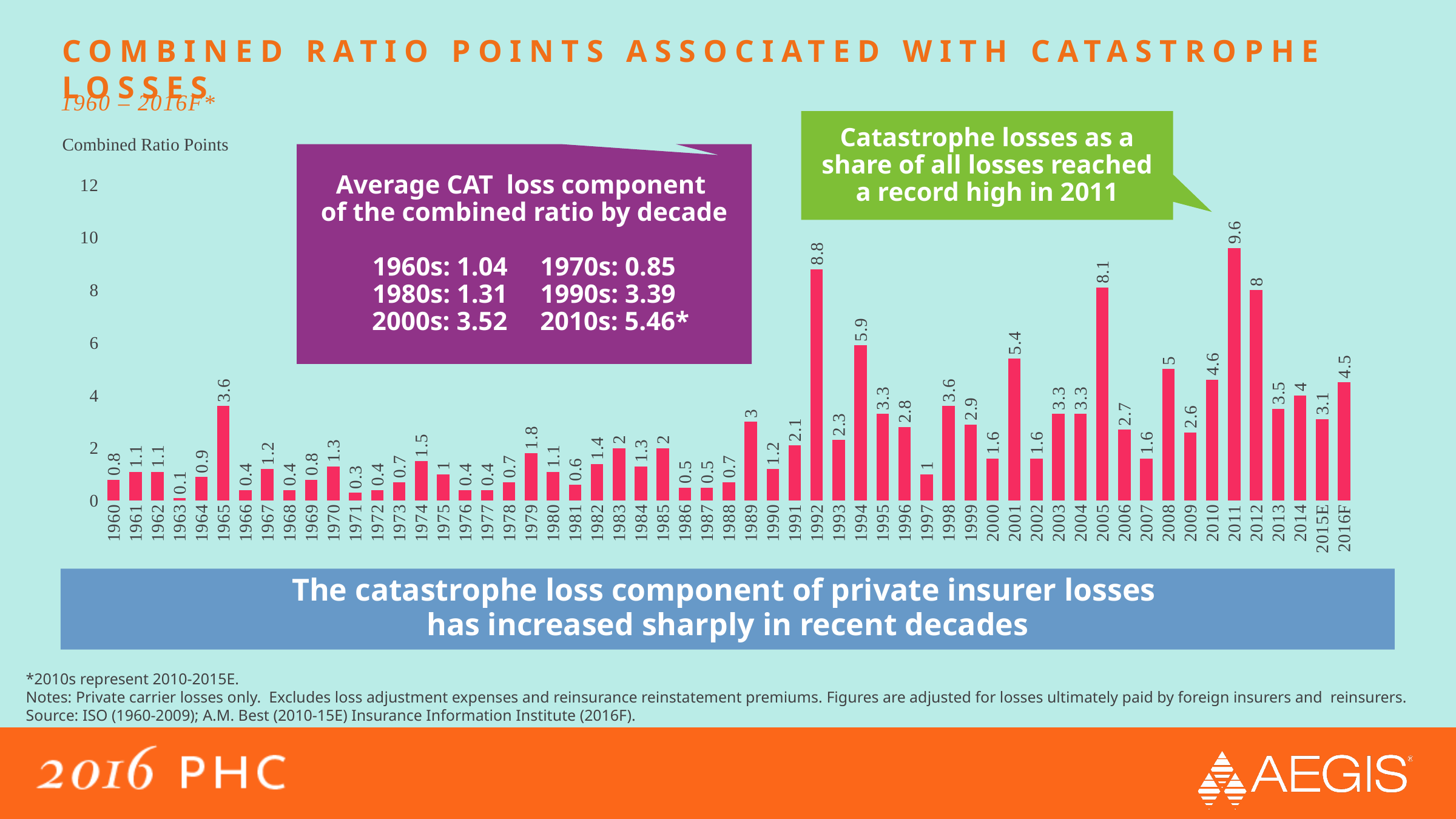
Which year has the lowest value? 1963 What is the value for 2016F? 4.5 What is the value for 1992? 8.8 What is the difference between the values for 2005 and 1994? 2.2 Which year has the highest value? 2011 What kind of chart is shown on the slide? bar chart Is the value for 1994 greater or less than 4? greater What is the value for 2011? 9.6 What is the value for 1965? 3.6 What is the difference between the values for 2011 and 2012? 1.6 According to the purple box, what is the average CAT loss component of the combined ratio for the 1990s? 3.39 Which is larger, the value for 2001 or the value for 2008? 2001